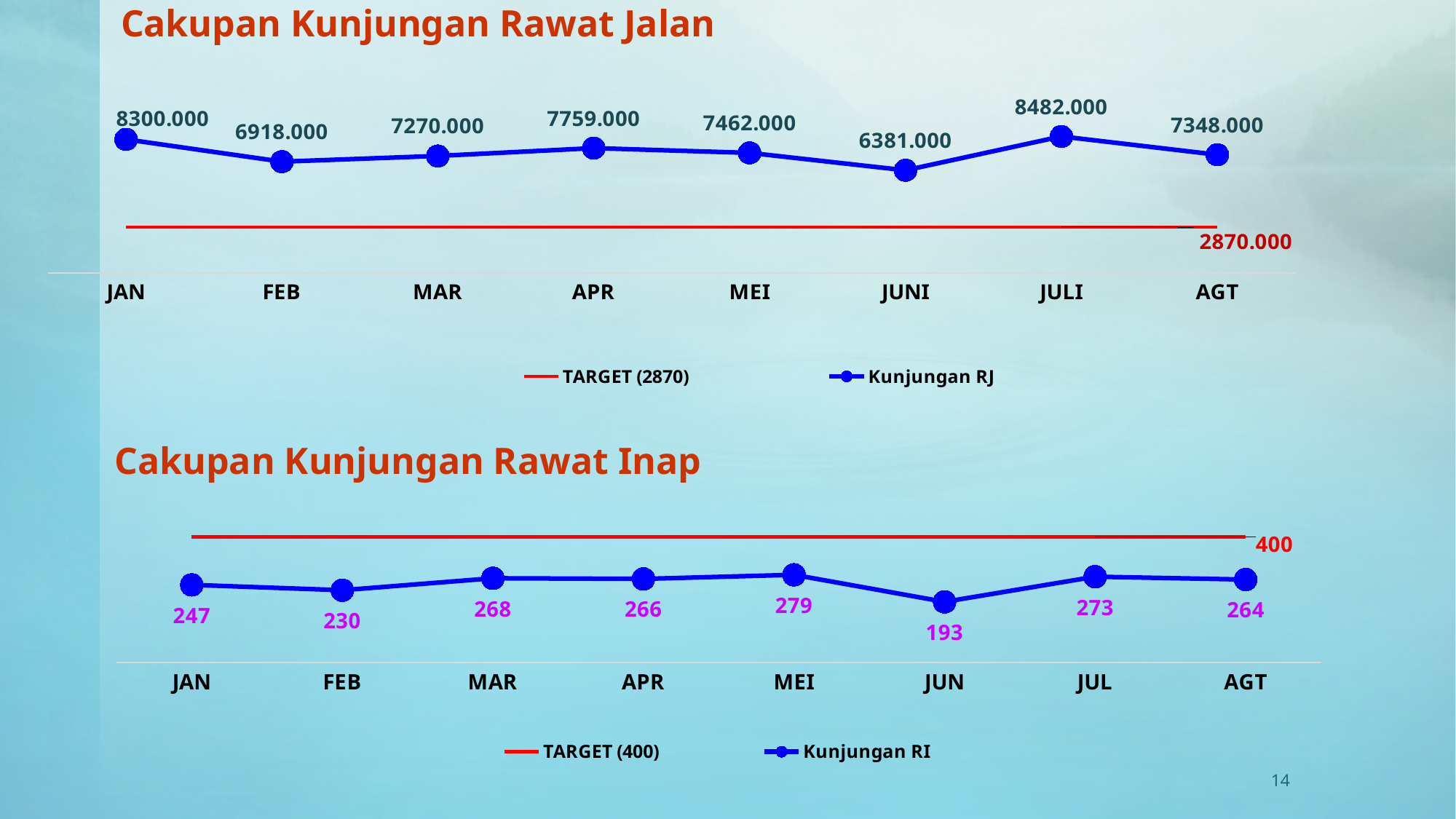
In the 'Cakupan Kunjungan Rawat Jalan' chart, what is the Kunjungan RJ value for JULI? 8482.000 In the 'Cakupan Kunjungan Rawat Jalan' chart, is the Kunjungan RJ value for JAN larger or smaller than for FEB? larger In the 'Cakupan Kunjungan Rawat Jalan' chart, how many months are shown on the x axis? 8 In the 'Cakupan Kunjungan Rawat Jalan' chart, which month has the lowest Kunjungan RJ value? JUNI In the 'Cakupan Kunjungan Rawat Inap' chart, which month has the lowest Kunjungan RI value? JUN In the 'Cakupan Kunjungan Rawat Jalan' chart, what is the value of the TARGET line? 2870.000 In the 'Cakupan Kunjungan Rawat Inap' chart, what is the Kunjungan RI value for MEI? 279 In the 'Cakupan Kunjungan Rawat Inap' chart, what is the difference between the Kunjungan RI values for MAR and FEB? 38 In the 'Cakupan Kunjungan Rawat Jalan' chart, which month has the highest Kunjungan RJ value? JULI What type of chart is 'Cakupan Kunjungan Rawat Inap'? line chart In the 'Cakupan Kunjungan Rawat Inap' chart, what is the value of the TARGET line? 400 In the 'Cakupan Kunjungan Rawat Inap' chart, how many series does the legend list? 2